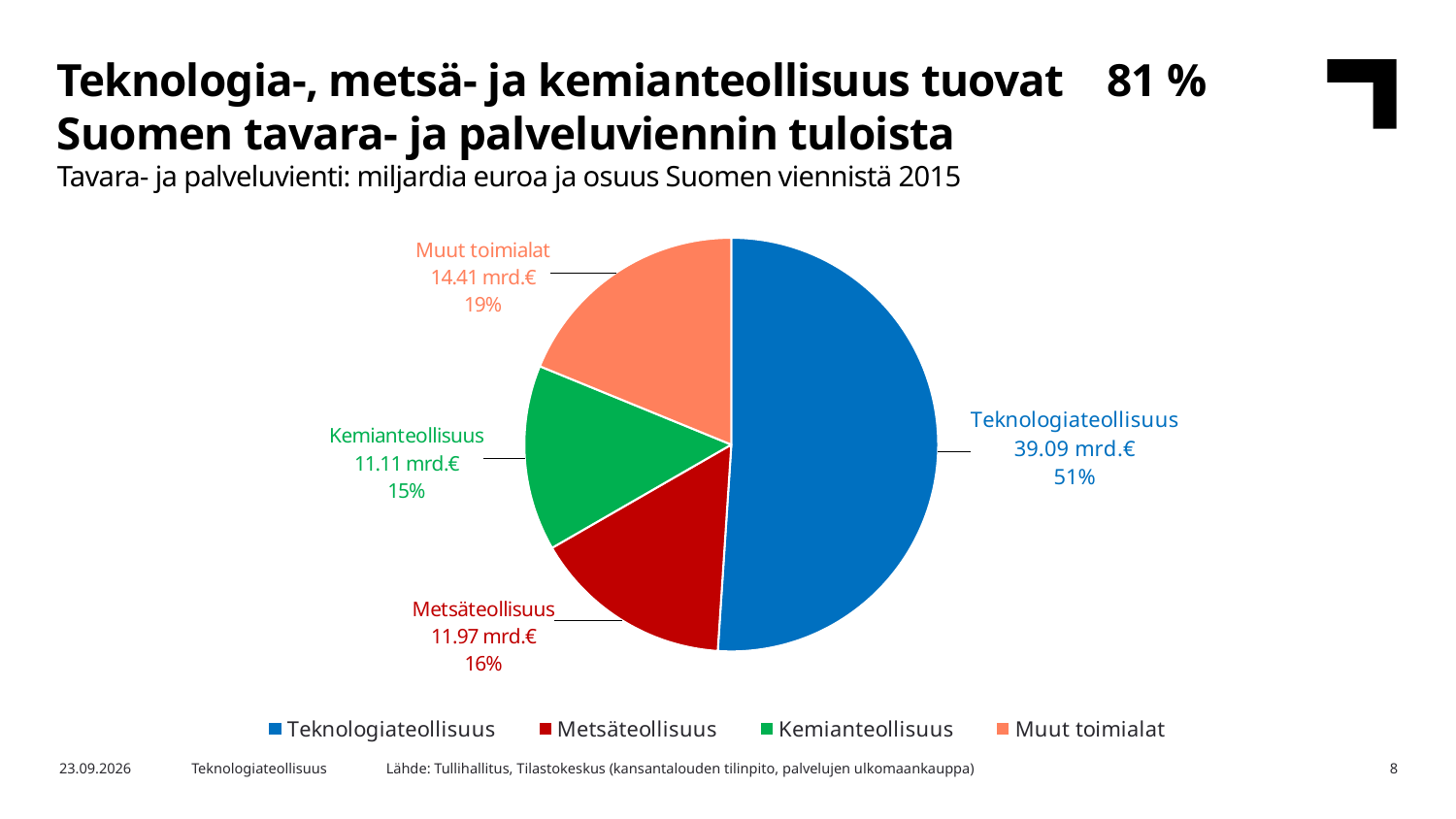
What is the value for Teknologiateollisuus? 39.09 mrd.€ Which colour represents Metsäteollisuus in the legend? Red What is the value for Muut toimialat? 14.41 mrd.€ What share of the pie does Kemianteollisuus represent? 15% How many slices does the pie chart have? 4 What is the value for Kemianteollisuus? 11.11 mrd.€ What is the difference between the values for Teknologiateollisuus and Muut toimialat? 24.68 mrd.€ What kind of chart is shown on the slide? Pie chart What is the value for Metsäteollisuus? 11.97 mrd.€ Which category has the largest slice? Teknologiateollisuus What share of the pie does Teknologiateollisuus represent? 51% Which category has the smallest slice? Kemianteollisuus